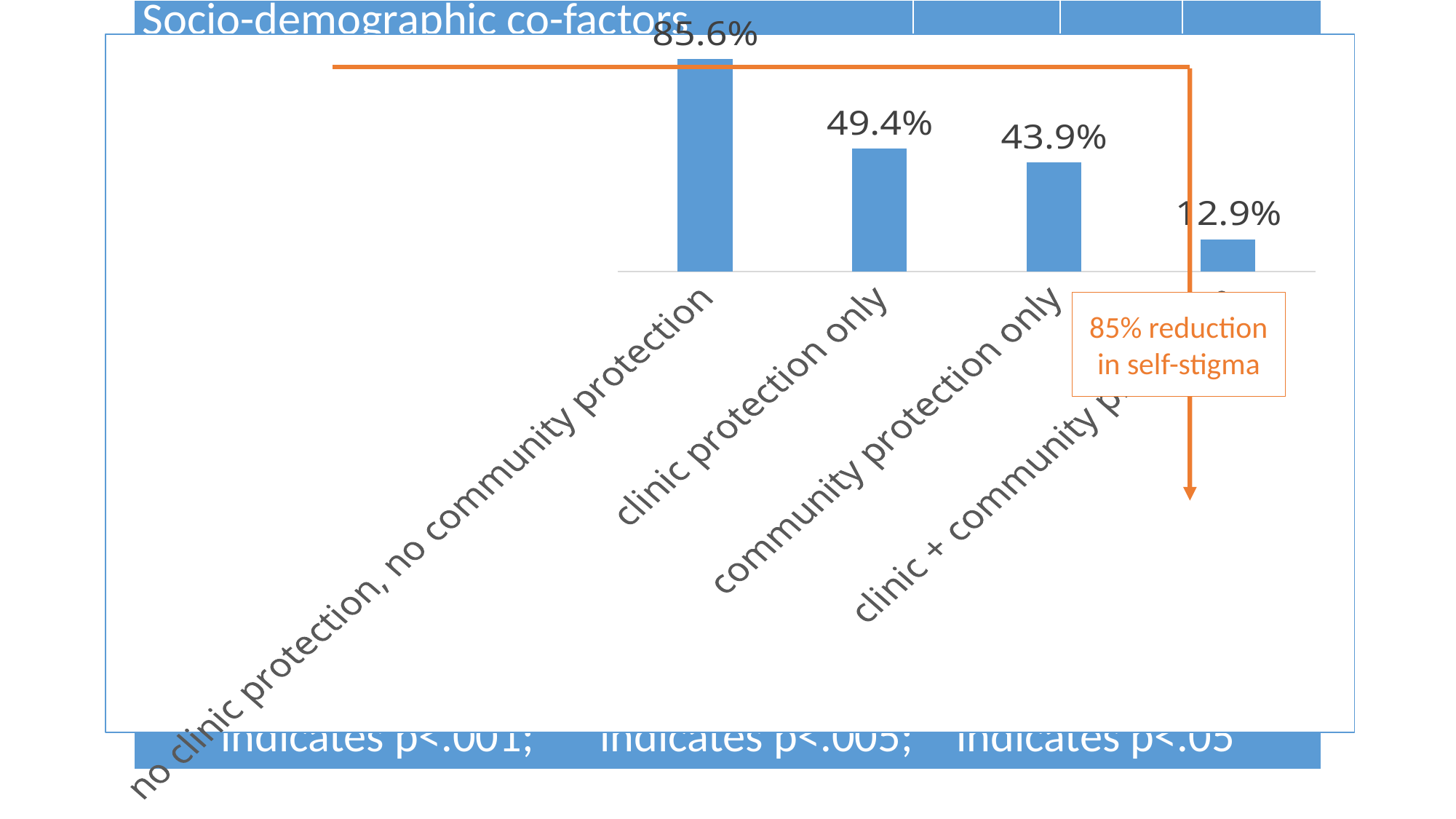
What is the value for 'community protection only'? 43.9% Do the bar values rise or fall from left to right across the categories? fall What is the value for 'no clinic protection, no community protection'? 85.6% Which is larger, 'clinic protection only' or 'community protection only'? clinic protection only How many bars does the chart show? 4 What kind of chart is shown on the slide? bar chart Which category has the highest value? no clinic protection, no community protection What is the difference between the highest bar and the lowest bar? 72.7% What is the value of the rightmost bar (clinic + community protection)? 12.9% What is the difference between 'clinic protection only' and 'community protection only'? 5.5% Which category has the lowest value? clinic + community protection What is the value for 'clinic protection only'? 49.4%